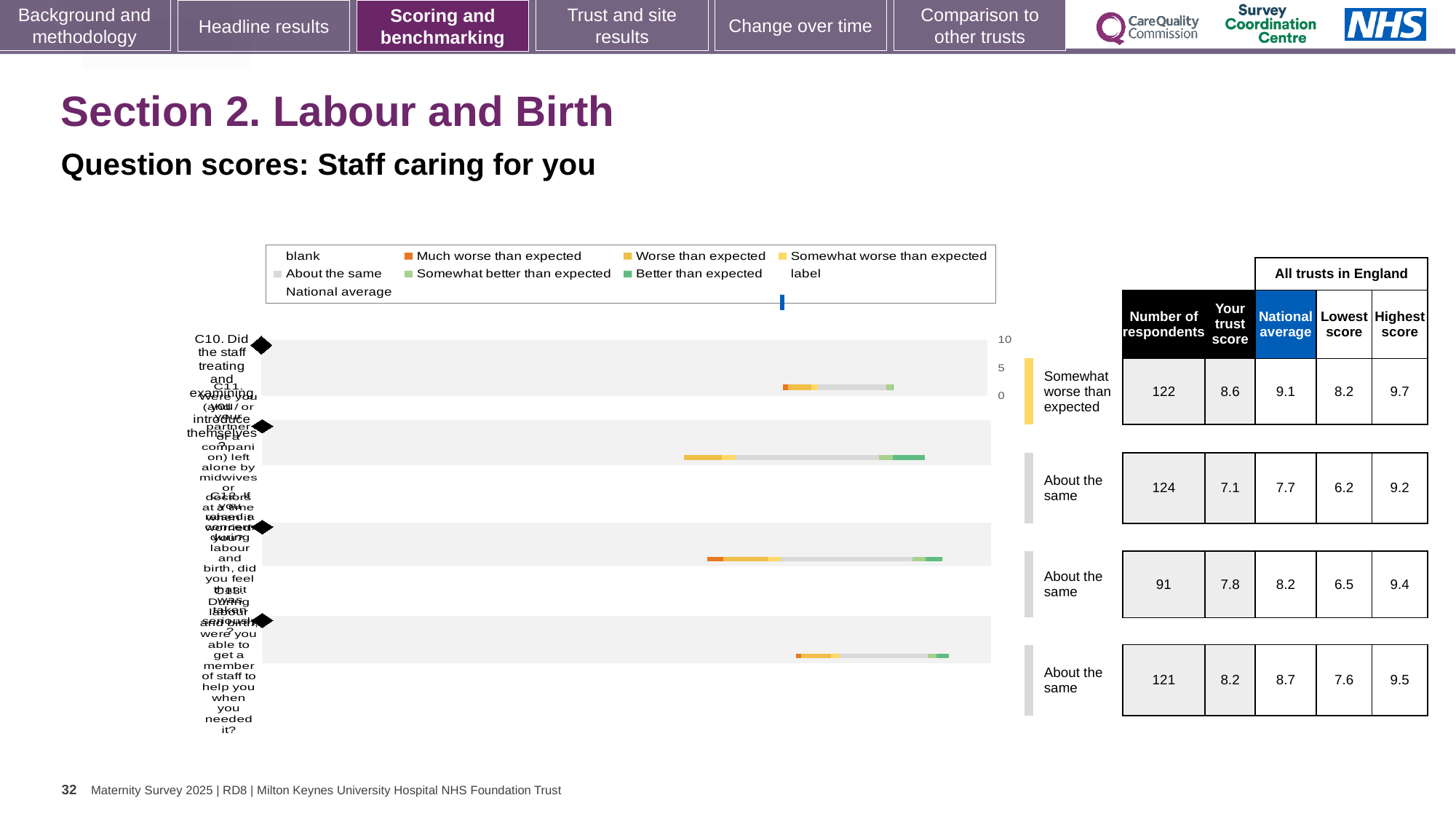
What benchmark category is given for the first row (C10)? Somewhat worse than expected Which has the larger trust score, the third row (C12) or the fourth row (C13)? C13 (fourth row), 8.2 What is the lowest score across all trusts in England for the third row (C12)? 6.5 Which row has the highest trust score? C10 (first row), 8.6 What is the number of respondents for the first row (C10, staff introducing themselves)? 122 What is the trust score for the second row (C11, left alone by midwives or doctors)? 7.1 Which row has the lowest number of respondents? C12 (third row), 91 What kind of chart is shown on the slide? bar chart What is the highest score across all trusts in England for the second row (C11)? 9.2 How many questions (rows) are plotted in the chart? 4 How many rows are rated 'About the same'? 3 For the fourth row (C13), how much higher is the national average than the trust score? 0.5